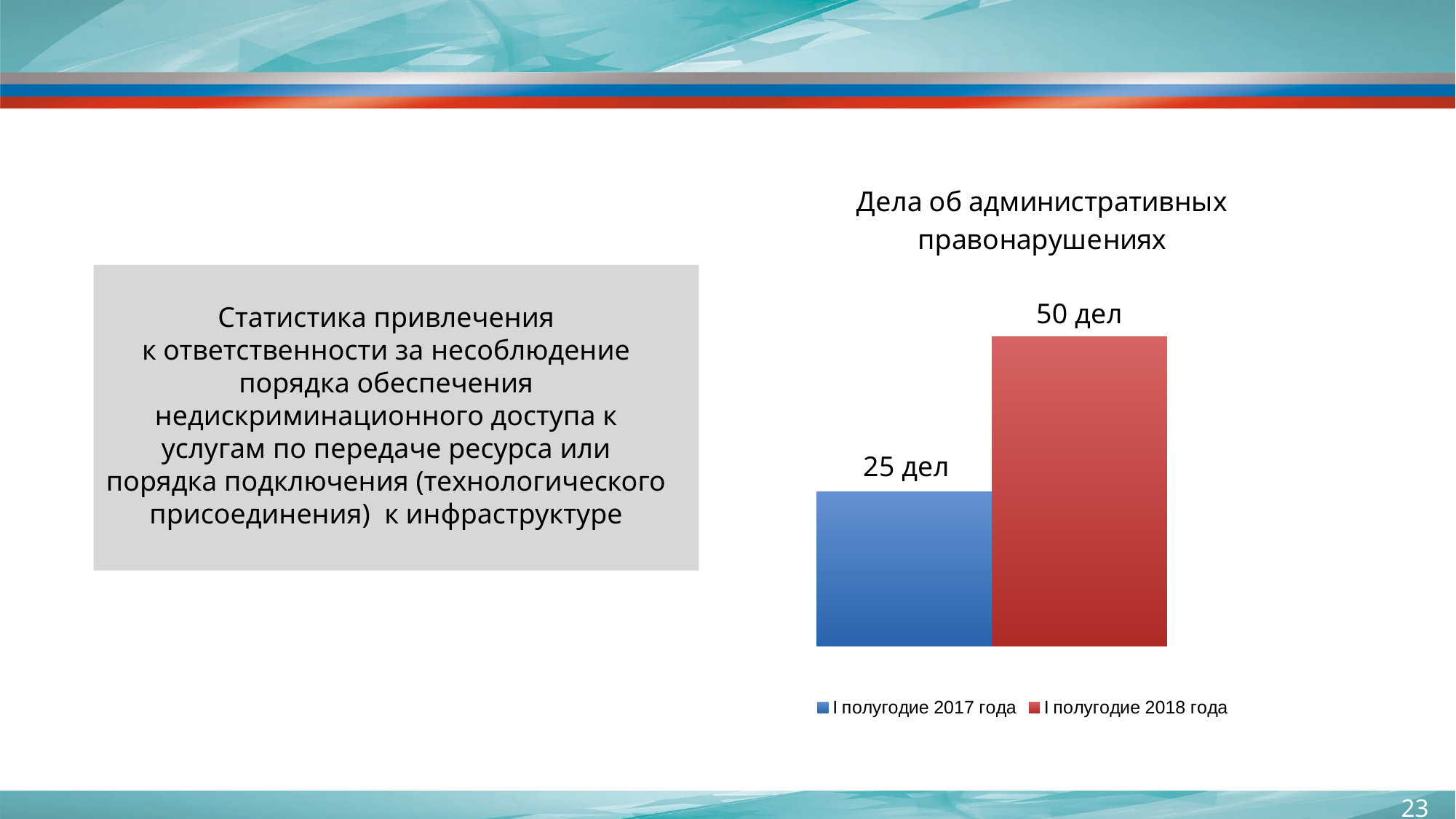
What is the title of the chart? Дела об административных правонарушениях How many bars are plotted on the chart? 2 Which series has the lowest value? I полугодие 2017 года What colour is the bar for I полугодие 2018 года? Red Which series has the highest value? I полугодие 2018 года What kind of chart is shown? Bar chart Did the number of cases rise or fall from I полугодие 2017 года to I полугодие 2018 года? Rise What is the value for I полугодие 2018 года? 50 дел What is the value for I полугодие 2017 года? 25 дел Which is larger: the value for I полугодие 2017 года or I полугодие 2018 года? I полугодие 2018 года What is the difference between the values for I полугодие 2018 года and I полугодие 2017 года? 25 дел How many series does the legend list? 2